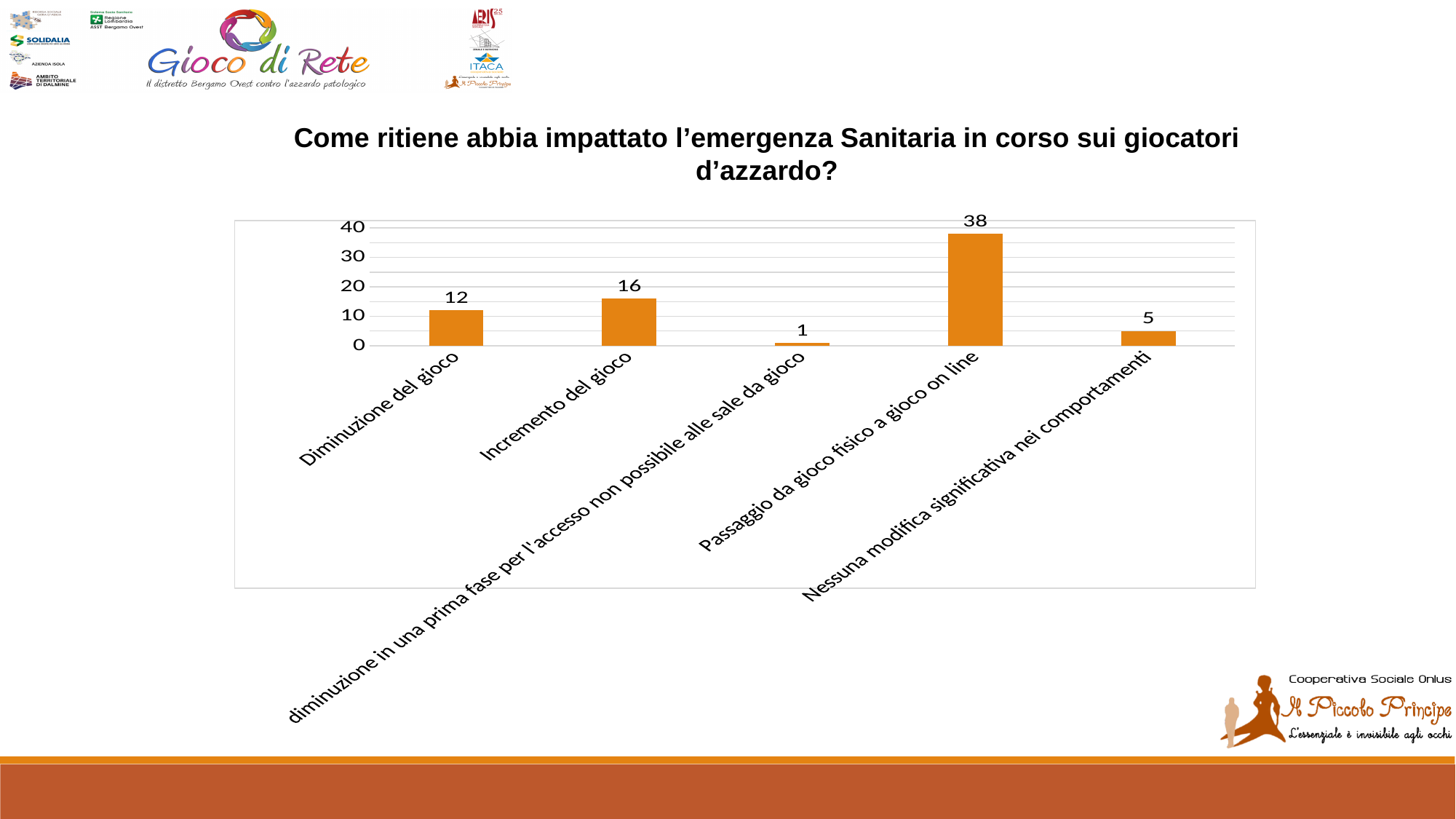
Which category has the lowest value? diminuzione in una prima fase per l'accesso non possibile alle sale da gioco What is the difference between the values for "Passaggio da gioco fisico a gioco on line" and "Incremento del gioco"? 22 What is the value for "Diminuzione del gioco"? 12 What is the value for "Nessuna modifica significativa nei comportamenti"? 5 Which is larger, the value for "Incremento del gioco" or the value for "Diminuzione del gioco"? Incremento del gioco What is the value for "Incremento del gioco"? 16 What kind of chart is shown on the slide? bar chart What is the title of the chart? Come ritiene abbia impattato l'emergenza Sanitaria in corso sui giocatori d'azzardo? Which category has the highest value? Passaggio da gioco fisico a gioco on line Is the value for "Passaggio da gioco fisico a gioco on line" greater or less than 30? greater How many categories are shown in the chart? 5 What is the value for "Passaggio da gioco fisico a gioco on line"? 38